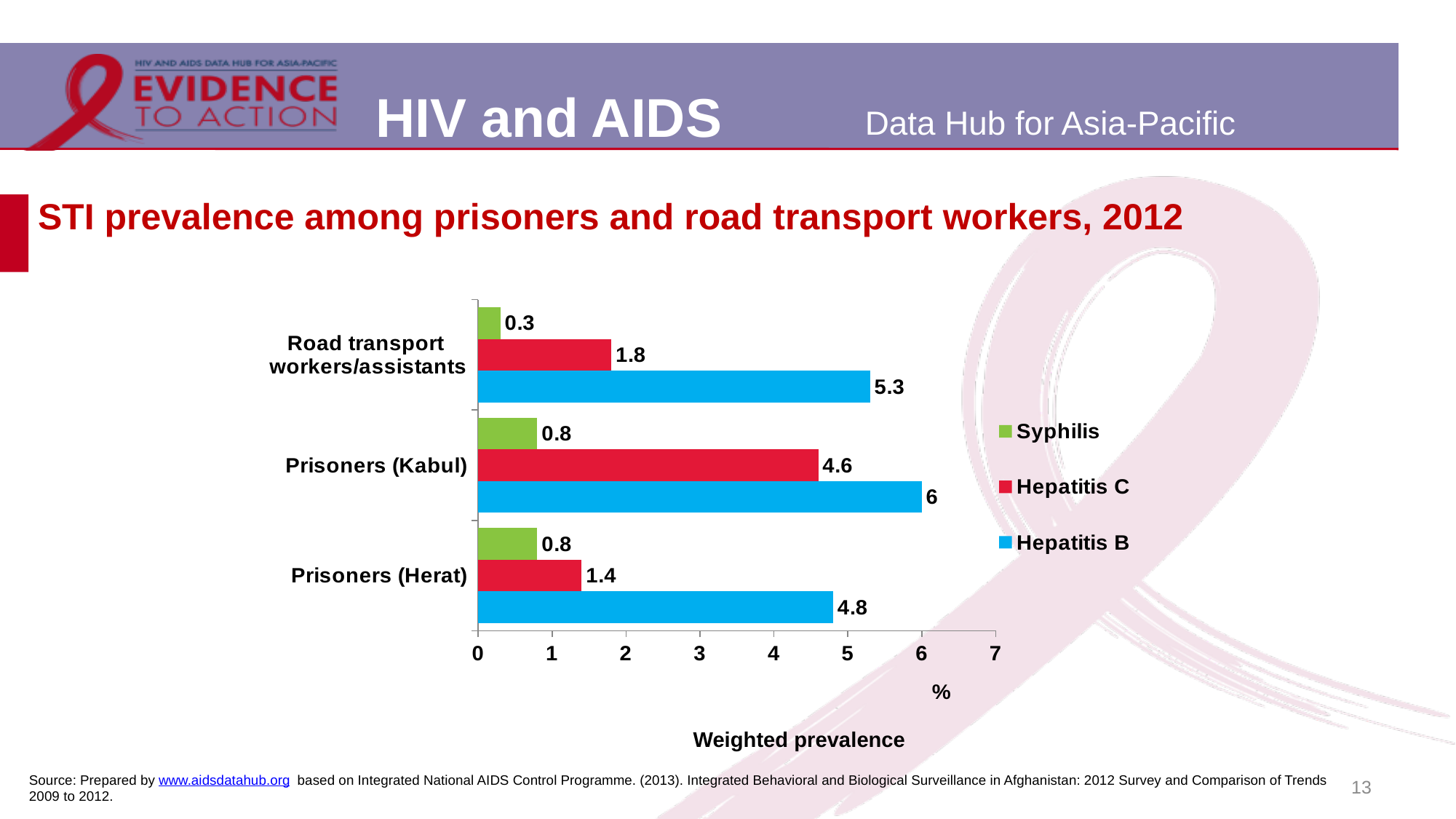
What is the Hepatitis B prevalence among Prisoners (Kabul)? 6 How many series does the legend list? 3 Is the Hepatitis C prevalence among Prisoners (Kabul) greater or less than 4? greater What is the Hepatitis C prevalence among Road transport workers/assistants? 1.8 What kind of chart is shown on the slide? Bar chart How many groups are shown on the chart? 3 Which group has the lowest Syphilis prevalence? Road transport workers/assistants What is the Syphilis prevalence among Prisoners (Herat)? 0.8 What is the difference between the Hepatitis C prevalence among Prisoners (Kabul) and Prisoners (Herat)? 3.2 What is the label on the horizontal axis of the chart? % Which is larger: Hepatitis B prevalence among Road transport workers/assistants or among Prisoners (Herat)? Road transport workers/assistants Which group has the highest Hepatitis B prevalence? Prisoners (Kabul)